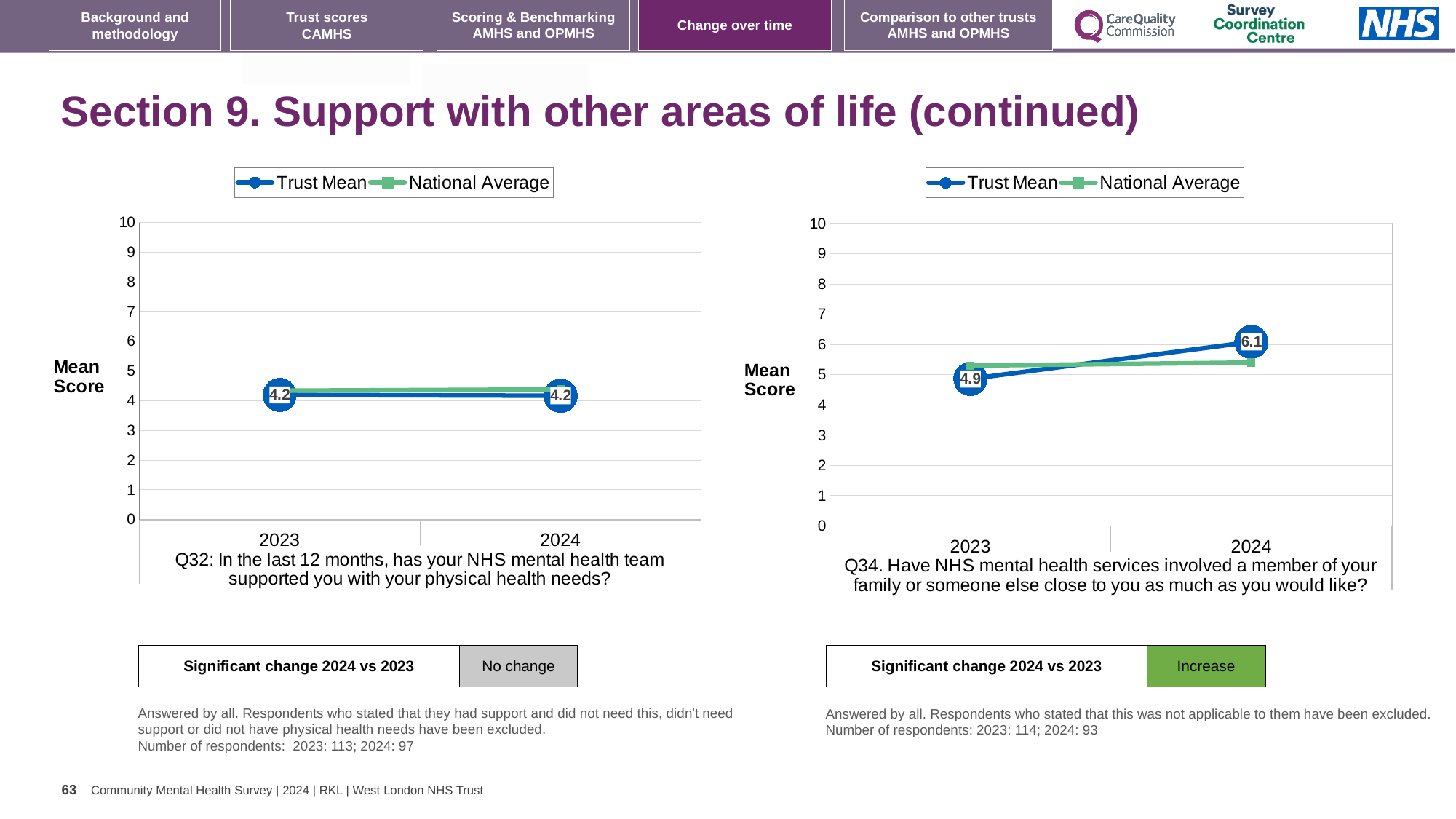
In the right chart (Q34), what is the Trust Mean value for 2023? 4.9 What kind of chart is the left chart (Q32)? line chart In the right chart (Q34), which year has the higher Trust Mean? 2024 In the left chart (Q32), what is the Trust Mean value for 2024? 4.2 In the left chart (Q32), is the Trust Mean value for 2024 greater or less than 5? less In the right chart (Q34), what is the Trust Mean value for 2024? 6.1 In the right chart (Q34), is the National Average value for 2024 greater or less than 6? less In the right chart (Q34), does the Trust Mean rise or fall from 2023 to 2024? rise In the right chart (Q34), what is the difference between the Trust Mean in 2024 and in 2023? 1.2 How many years are plotted on the x axis of the right chart (Q34)? 2 How many series does the legend of the left chart (Q32) list? 2 In the left chart (Q32), what is the Trust Mean value for 2023? 4.2